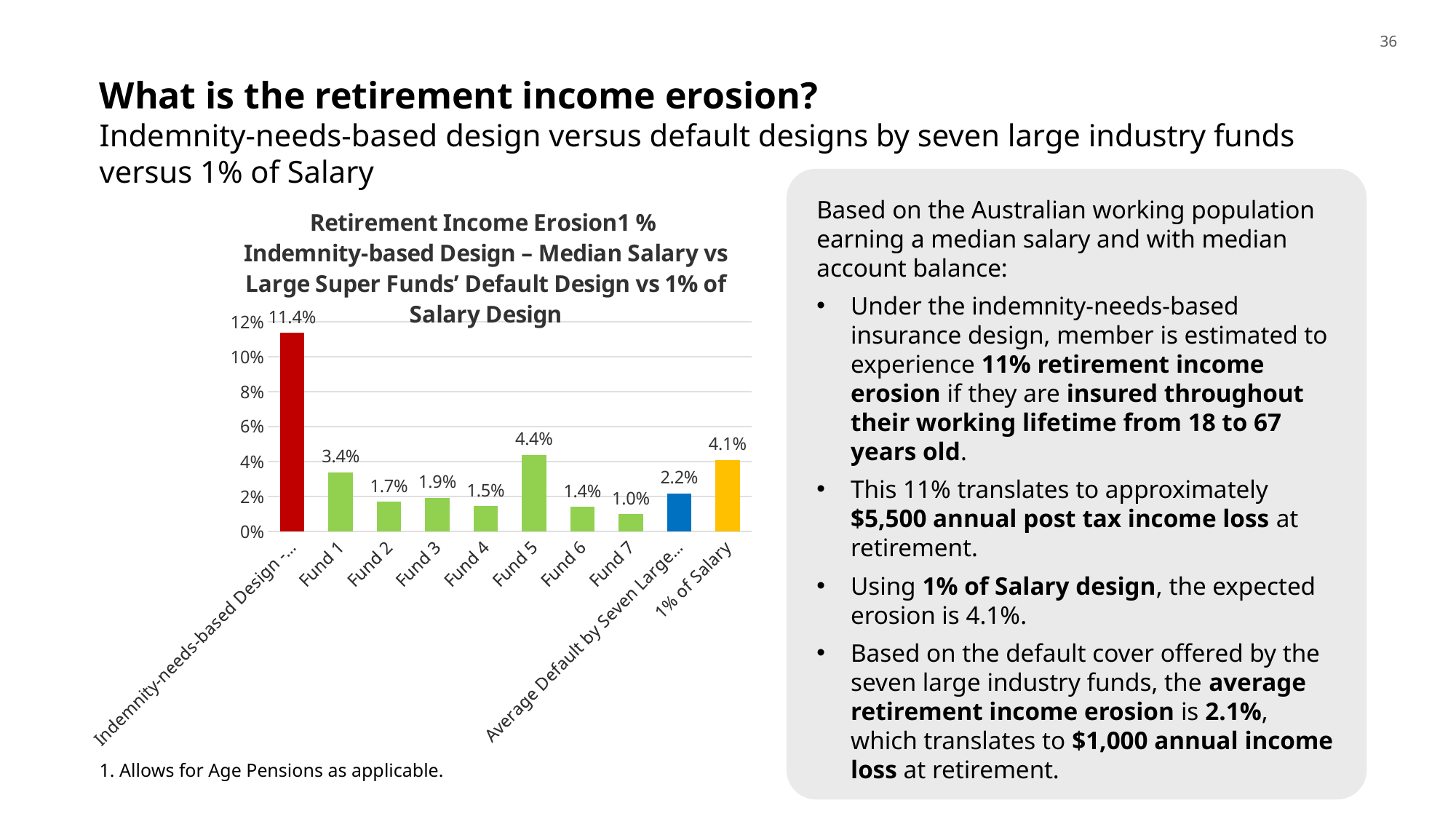
Which category has the highest value? Indemnity-needs-based Design What kind of chart is shown on the slide? Bar chart Which of the seven funds (Fund 1 to Fund 7) has the lowest value? Fund 7 What is the value for 1% of Salary? 4.1% Is the value for Fund 1 greater or less than 2%? greater What is the value for Fund 7? 1.0% What is the value for Fund 5? 4.4% What colour is the bar for 1% of Salary? Yellow How many bars are plotted in the chart? 10 What is the difference between the values for Fund 5 and Fund 1? 1.0% Which is larger, the value for Fund 3 or the value for Fund 4? Fund 3 What is the value shown for the first (red) bar, the Indemnity-needs-based Design? 11.4%